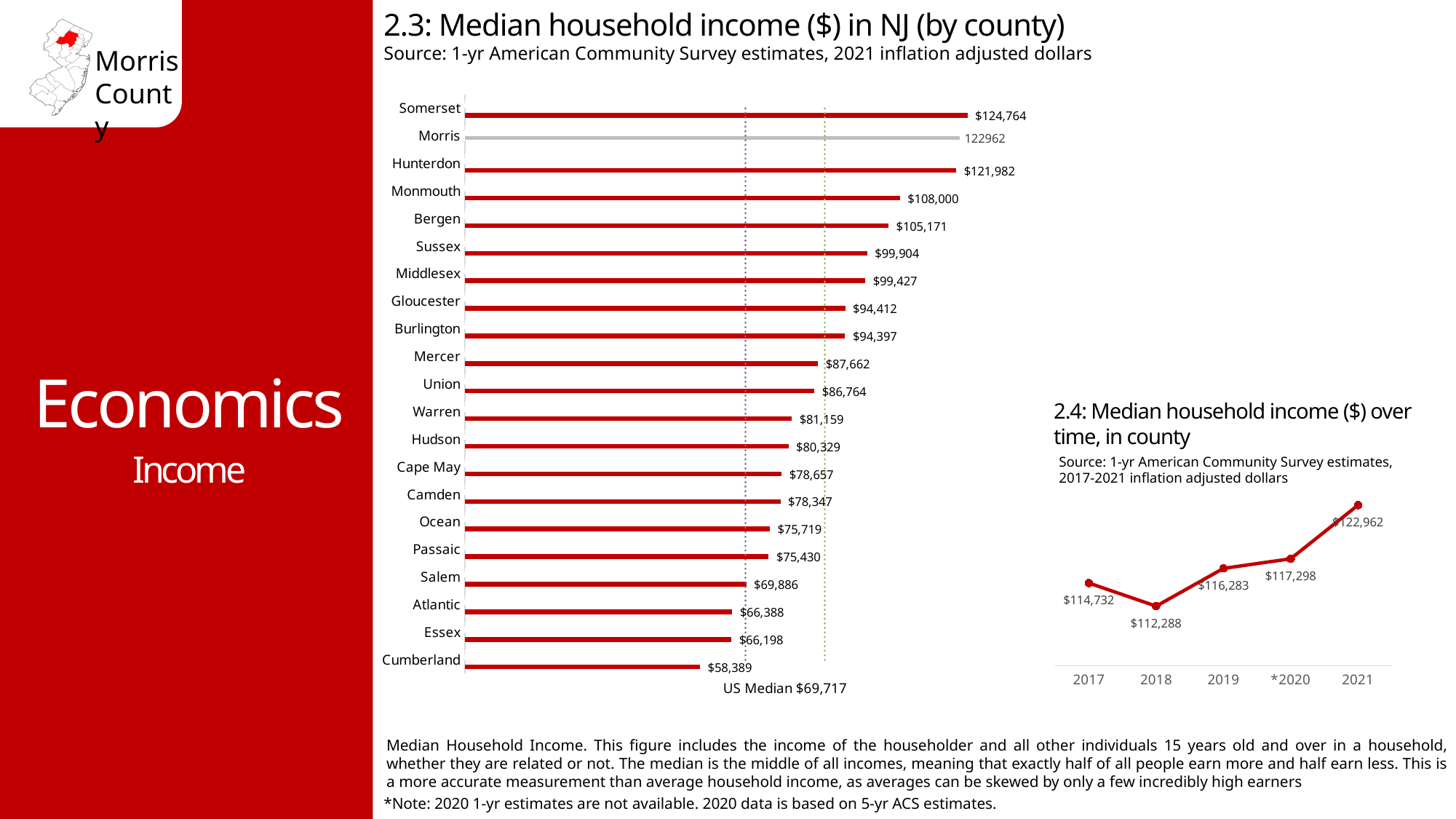
In chart 2.4 (Median household income over time, in county), what is the difference between the 2021 and 2017 values? $8,230 In chart 2.3 (Median household income in NJ by county), which county has the highest median household income? Somerset What type of chart is chart 2.4 (Median household income over time, in county)? Line chart In chart 2.3 (Median household income in NJ by county), which county has the lowest median household income? Cumberland In chart 2.4 (Median household income over time, in county), what is the median household income for 2018? $112,288 In chart 2.3 (Median household income in NJ by county), what is the median household income for Somerset? $124,764 What type of chart is chart 2.3 (Median household income in NJ by county)? Bar chart In chart 2.3 (Median household income in NJ by county), how many counties are shown? 21 In chart 2.3 (Median household income in NJ by county), what is the median household income for Cumberland? $58,389 In chart 2.4 (Median household income over time, in county), which year has the highest median household income? 2021 In chart 2.3 (Median household income in NJ by county), what is the difference between Somerset's and Cumberland's median household income? $66,375 In chart 2.3 (Median household income in NJ by county), which has a higher median household income, Monmouth or Bergen? Monmouth